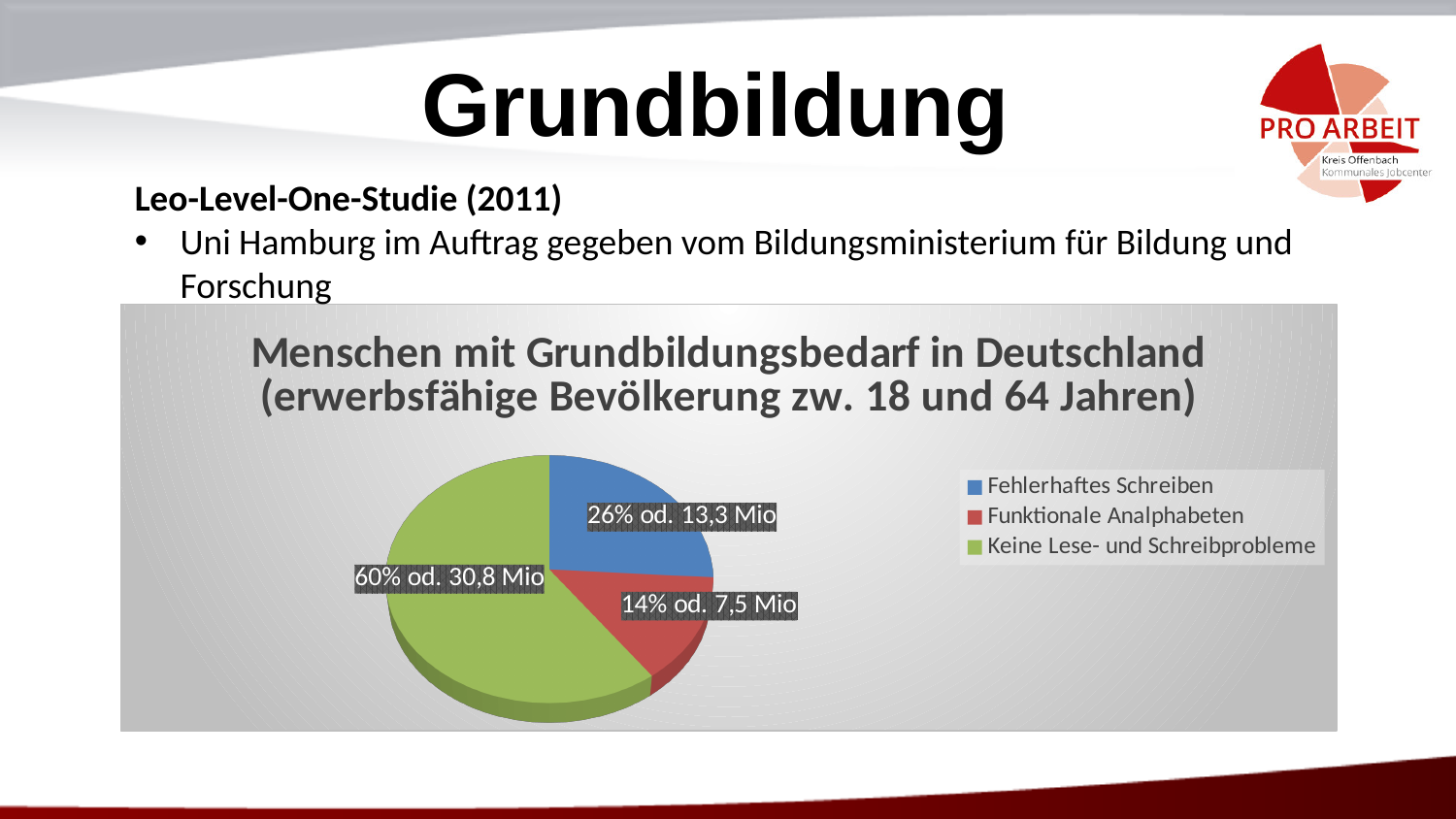
How many entries does the legend list? 3 What is the data label for the slice 'Funktionale Analphabeten'? 14% od. 7,5 Mio What colour is the slice for 'Keine Lese- und Schreibprobleme'? green How many slices does the pie chart have? 3 Which is larger, the slice for 'Fehlerhaftes Schreiben' or the slice for 'Funktionale Analphabeten'? Fehlerhaftes Schreiben What share of the pie does 'Funktionale Analphabeten' represent? 14% Which slice is the smallest? Funktionale Analphabeten What kind of chart is shown on the slide? pie chart Which slice is the largest? Keine Lese- und Schreibprobleme What is the data label for the slice 'Fehlerhaftes Schreiben'? 26% od. 13,3 Mio What is the title of the chart? Menschen mit Grundbildungsbedarf in Deutschland (erwerbsfähige Bevölkerung zw. 18 und 64 Jahren) What is the data label for the slice 'Keine Lese- und Schreibprobleme'? 60% od. 30,8 Mio